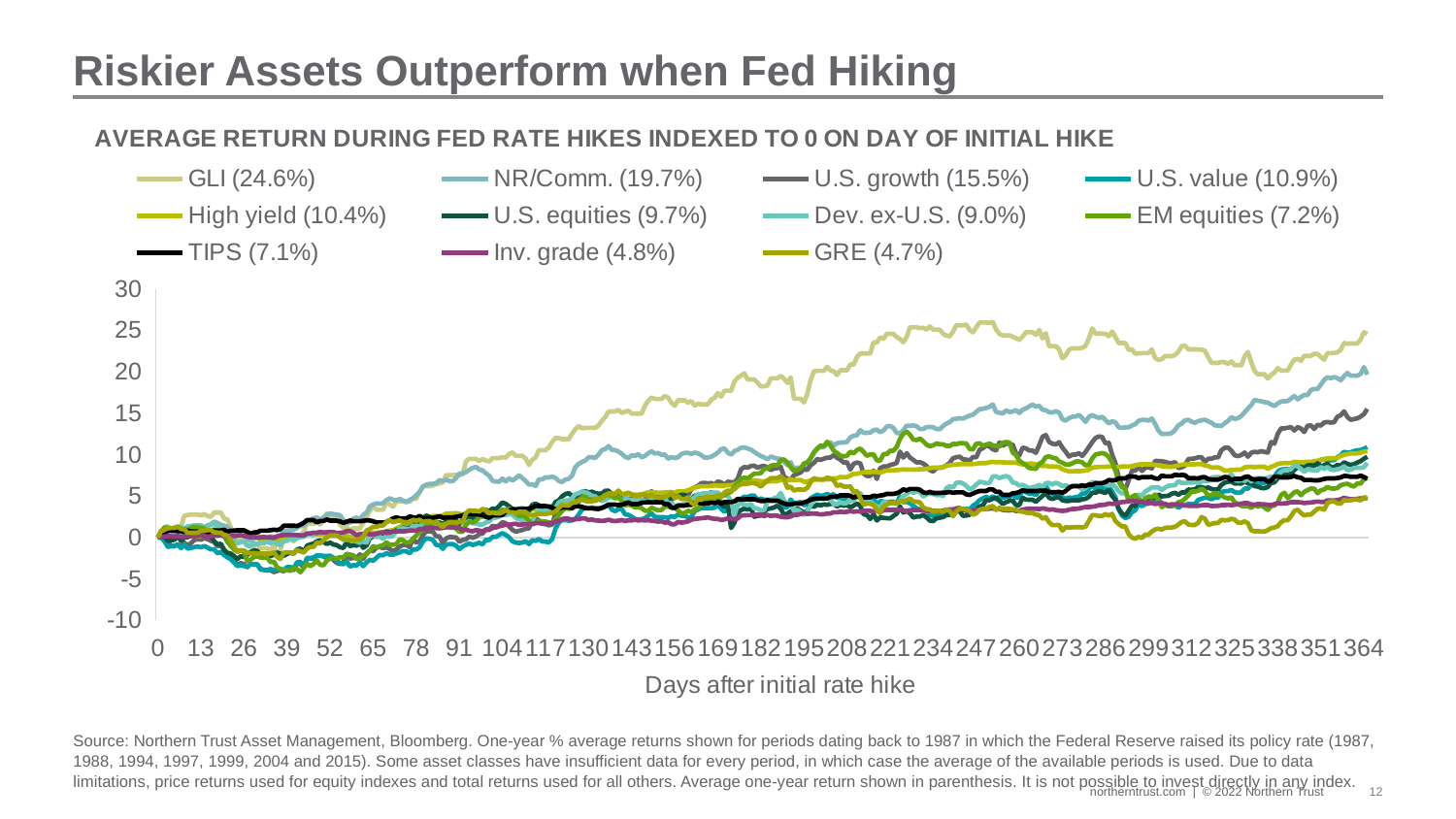
What is the label of the x axis? Days after initial rate hike What average one-year return is shown in the legend for NR/Comm.? 19.7% Which has the larger legend return, U.S. growth or U.S. value? U.S. growth Which series has the lowest average one-year return shown in the legend? GRE (4.7%) What kind of chart is shown on the slide? line chart How many series does the legend list? 11 Which series has the highest average one-year return shown in the legend? GLI (24.6%) What average one-year return is shown in the legend for GLI? 24.6% Does the GLI line generally rise or fall across the days after the initial rate hike? rise What is the difference between the legend returns for GLI (24.6%) and GRE (4.7%)? 19.9 percentage points Is the value of the GLI line at day 364 greater or less than 20? greater What average one-year return is shown in the legend for TIPS? 7.1%